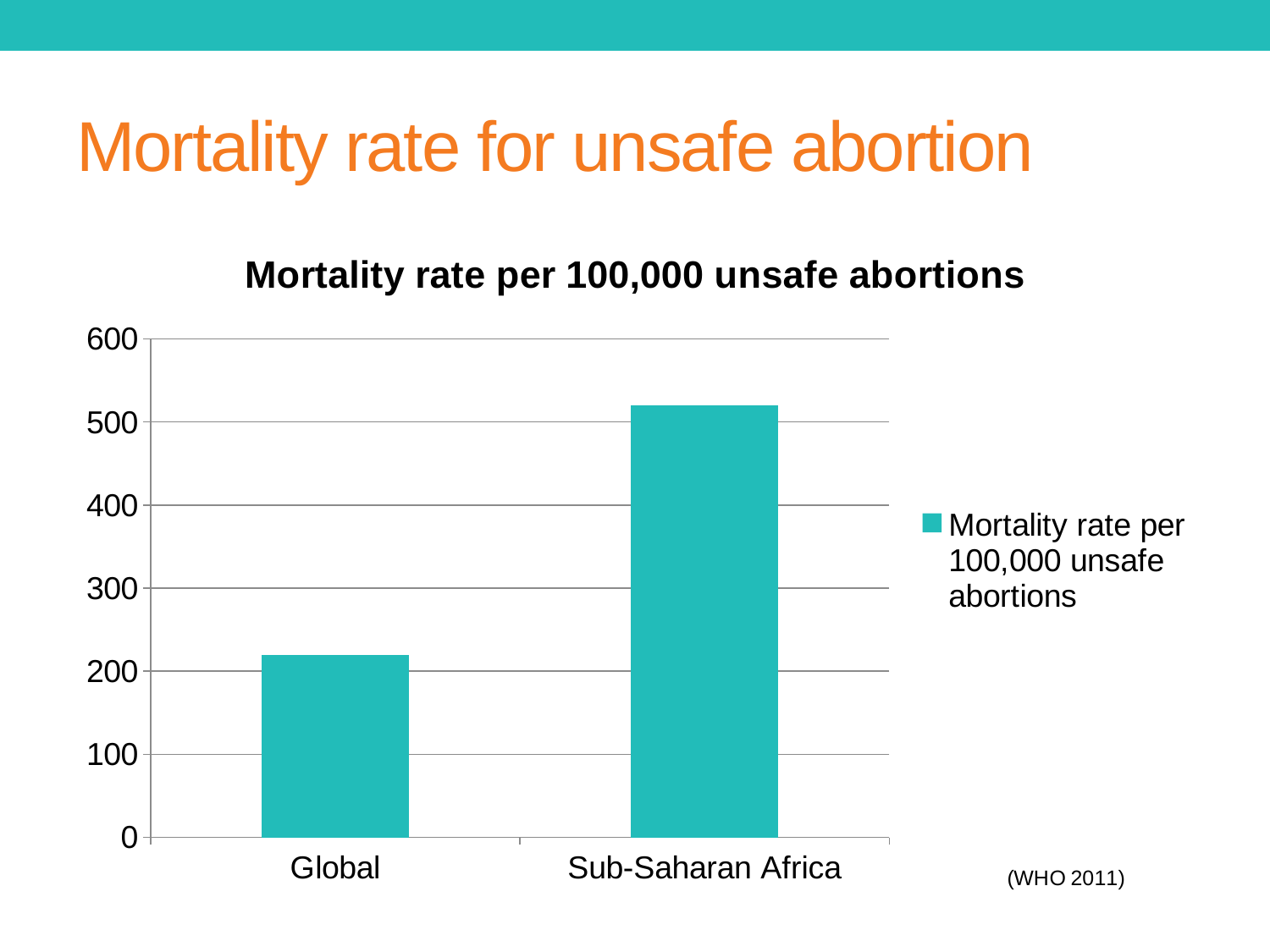
What type of chart is shown on the slide? bar chart What is the title of the chart? Mortality rate per 100,000 unsafe abortions How many series does the legend list? 1 Is the value for Sub-Saharan Africa greater or less than 500? greater Is the value for Global greater or less than 300? less Is the value for Global greater or less than 200? greater What source is cited below the chart? WHO 2011 Which category has the highest mortality rate? Sub-Saharan Africa Which is larger, the mortality rate for Global or for Sub-Saharan Africa? Sub-Saharan Africa Which category has the lowest mortality rate? Global How many categories are shown on the x axis of the chart? 2